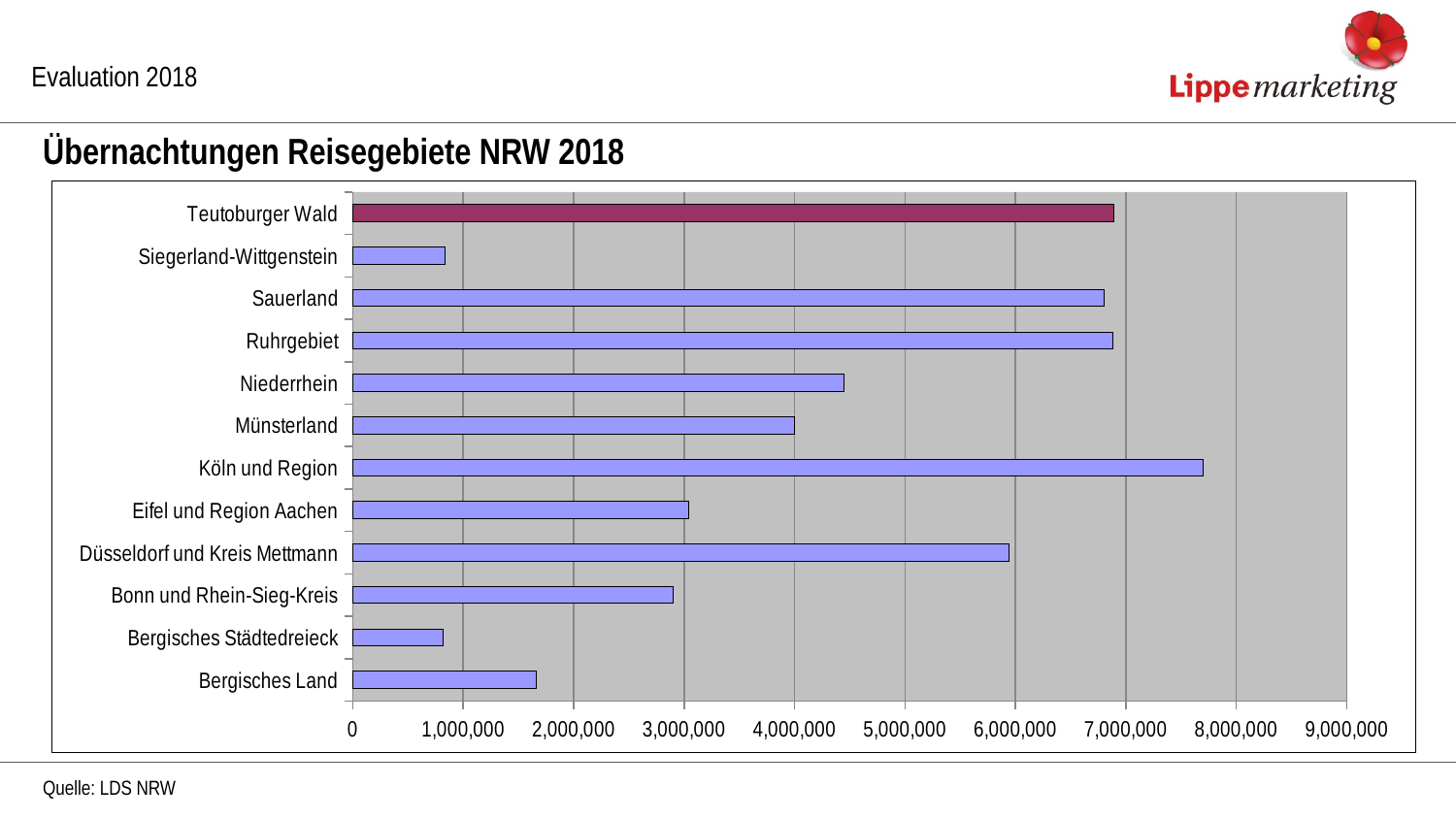
How many travel regions (categories) are plotted in the chart? 12 Is the value for Niederrhein greater or less than 4,000,000? greater Which region's bar is shown in a different colour (dark red) from the others? Teutoburger Wald Is the value for Köln und Region greater or less than 7,000,000? greater Which region has the highest number of overnight stays in the chart? Köln und Region Which has more overnight stays, Bergisches Land or Bergisches Städtedreieck? Bergisches Land Is the value for Bergisches Land greater or less than 2,000,000? less Which has more overnight stays, Köln und Region or Teutoburger Wald? Köln und Region What kind of chart is shown on the slide? bar chart Which has more overnight stays, Niederrhein or Münsterland? Niederrhein